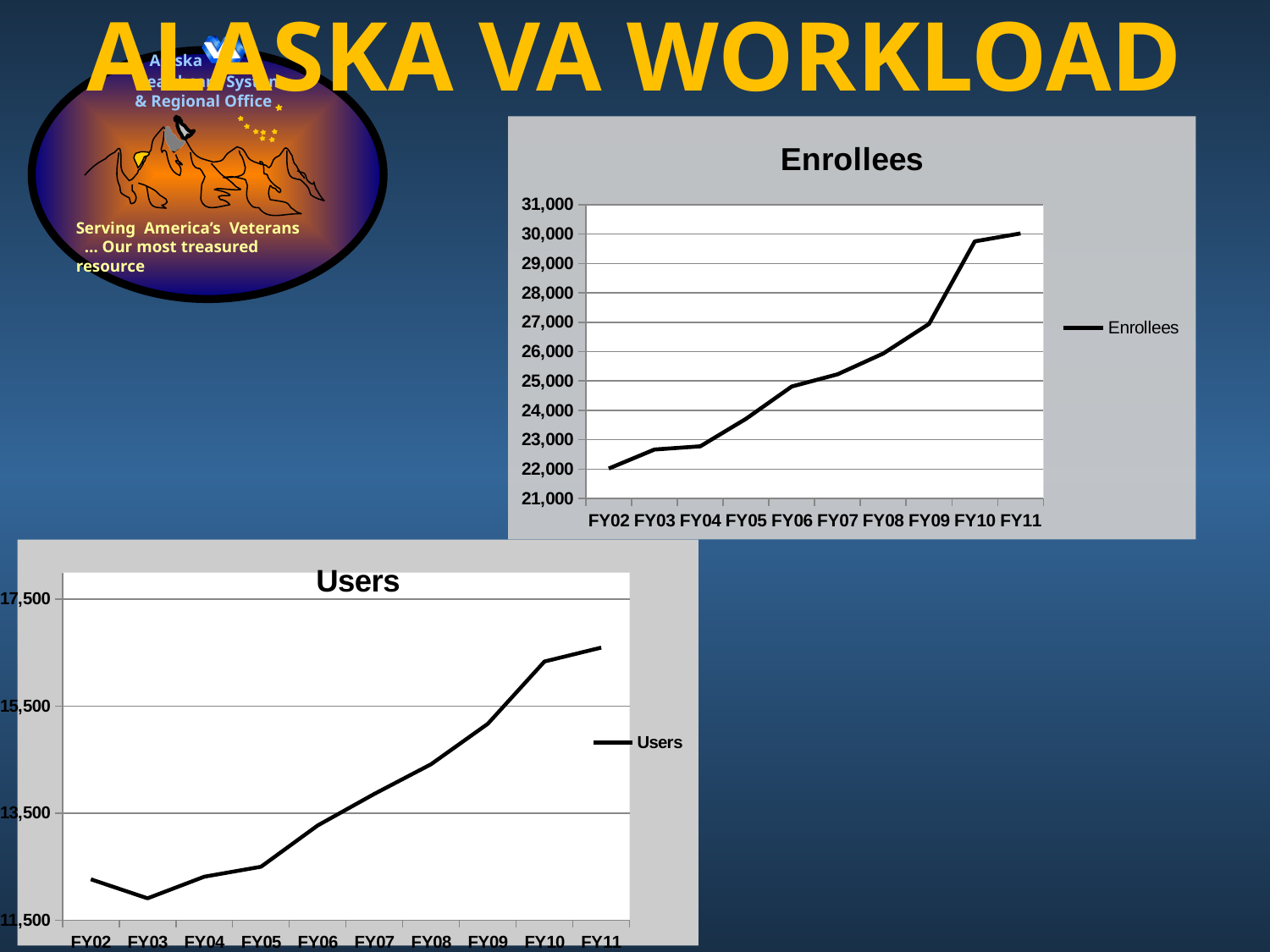
In the Enrollees chart, which fiscal year has the highest value? FY11 In the Enrollees chart, which fiscal year has the lowest value? FY02 What kind of chart is the Users chart? line chart In the Users chart, which fiscal year has the lowest value? FY03 In the Users chart, do the values generally rise or fall from FY02 to FY11? rise In the Users chart, how many fiscal years are shown on the x axis? 10 In the Enrollees chart, how many fiscal years are shown on the x axis? 10 In the Enrollees chart, is the value for FY10 greater or less than 29,000? greater In the Users chart, is the value for FY10 greater or less than 15,500? greater In the Users chart, which fiscal year has the highest value? FY11 In the Enrollees chart, is the value for FY02 greater or less than 23,000? less What kind of chart is the Enrollees chart? line chart